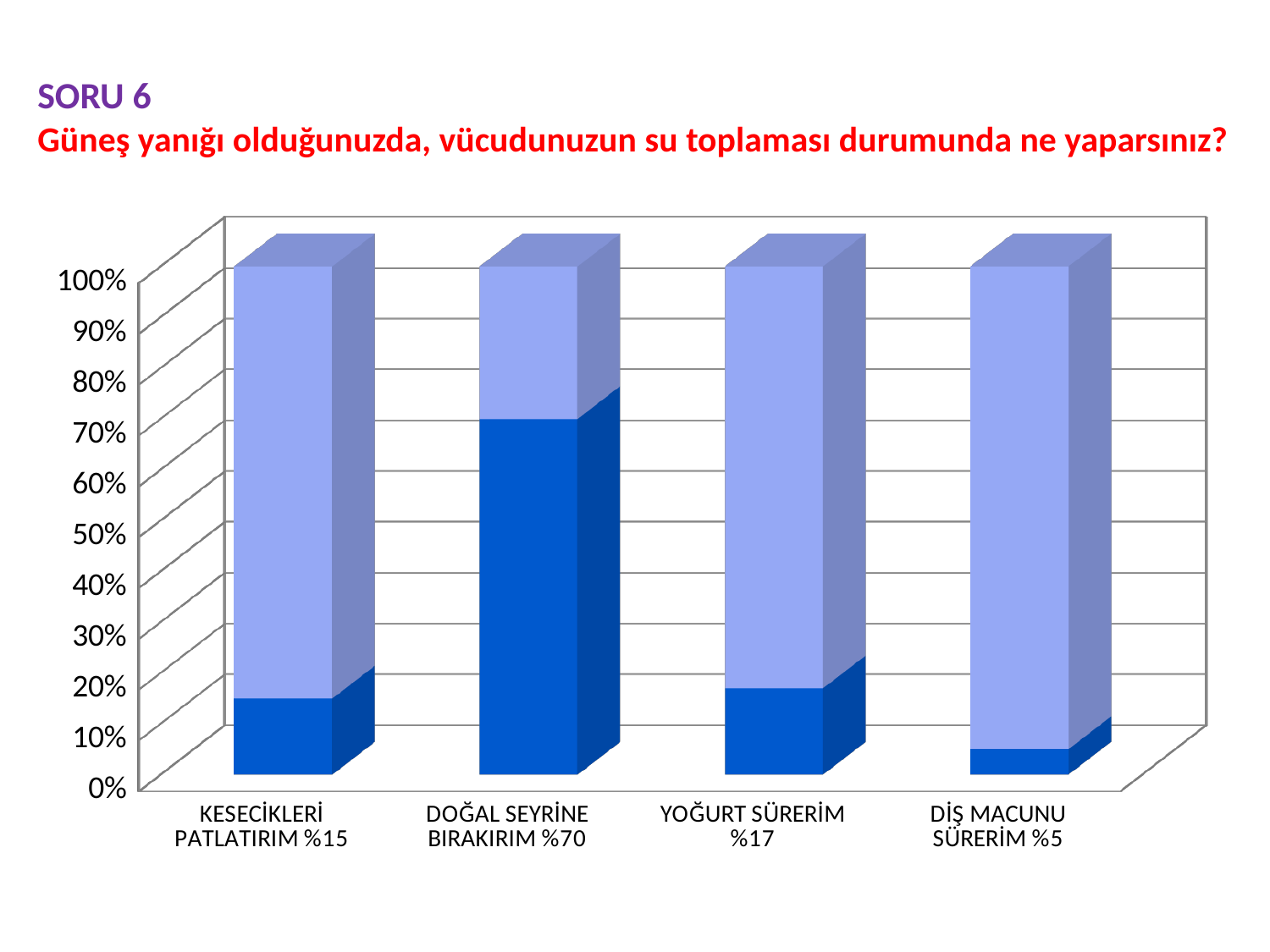
What kind of chart is shown on the slide? Stacked bar chart What is the difference in percentage points between DOĞAL SEYRİNE BIRAKIRIM and YOĞURT SÜRERİM? 53 What percentage is shown for KESECİKLERİ PATLATIRIM? %15 Which category has the highest percentage? DOĞAL SEYRİNE BIRAKIRIM Is the dark blue portion for DOĞAL SEYRİNE BIRAKIRIM greater or less than 50%? greater What percentage is shown for DİŞ MACUNU SÜRERİM? %5 What percentage is shown for DOĞAL SEYRİNE BIRAKIRIM? %70 Which is larger, the percentage for YOĞURT SÜRERİM or for KESECİKLERİ PATLATIRIM? YOĞURT SÜRERİM Which category has the lowest percentage? DİŞ MACUNU SÜRERİM What is the question text shown in red above the chart? Güneş yanığı olduğunuzda, vücudunuzun su toplaması durumunda ne yaparsınız? How many categories are shown on the x axis? 4 What percentage is shown for YOĞURT SÜRERİM? %17